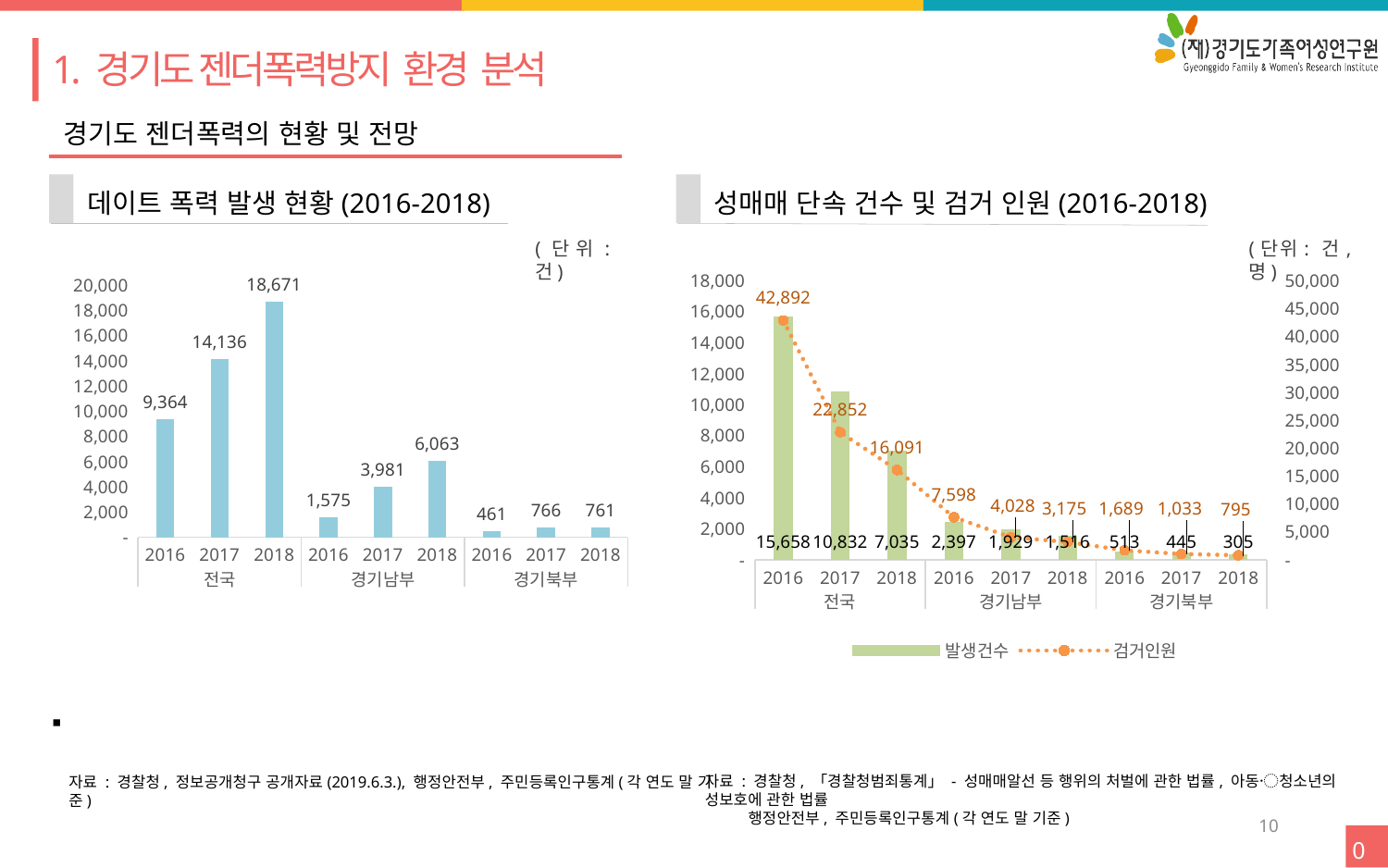
In the '데이트 폭력 발생 현황 (2016-2018)' chart, what is the value for 전국 in 2018? 18,671 In the '성매매 단속 건수 및 검거 인원 (2016-2018)' chart, how many series does the legend list? 2 In the '성매매 단속 건수 및 검거 인원 (2016-2018)' chart, what is the 검거인원 value for 경기남부 in 2018? 3,175 In the '성매매 단속 건수 및 검거 인원 (2016-2018)' chart, what is the 발생건수 value for 전국 in 2016? 15,658 In the '데이트 폭력 발생 현황 (2016-2018)' chart, do the 경기남부 values rise or fall from 2016 to 2018? rise In the '성매매 단속 건수 및 검거 인원 (2016-2018)' chart, which is larger: the 발생건수 for 경기북부 in 2017 or in 2018? 2017 In the '성매매 단속 건수 및 검거 인원 (2016-2018)' chart, how many bars are plotted? 9 What kind of chart is the '데이트 폭력 발생 현황 (2016-2018)' chart? bar chart In the '데이트 폭력 발생 현황 (2016-2018)' chart, what is the value for 경기남부 in 2017? 3,981 In the '데이트 폭력 발생 현황 (2016-2018)' chart, which bar has the lowest value? 경기북부 2016 In the '성매매 단속 건수 및 검거 인원 (2016-2018)' chart, what is the difference between the 검거인원 values for 전국 in 2016 and 2017? 20,040 In the '데이트 폭력 발생 현황 (2016-2018)' chart, what is the difference between the 전국 values for 2018 and 2017? 4,535